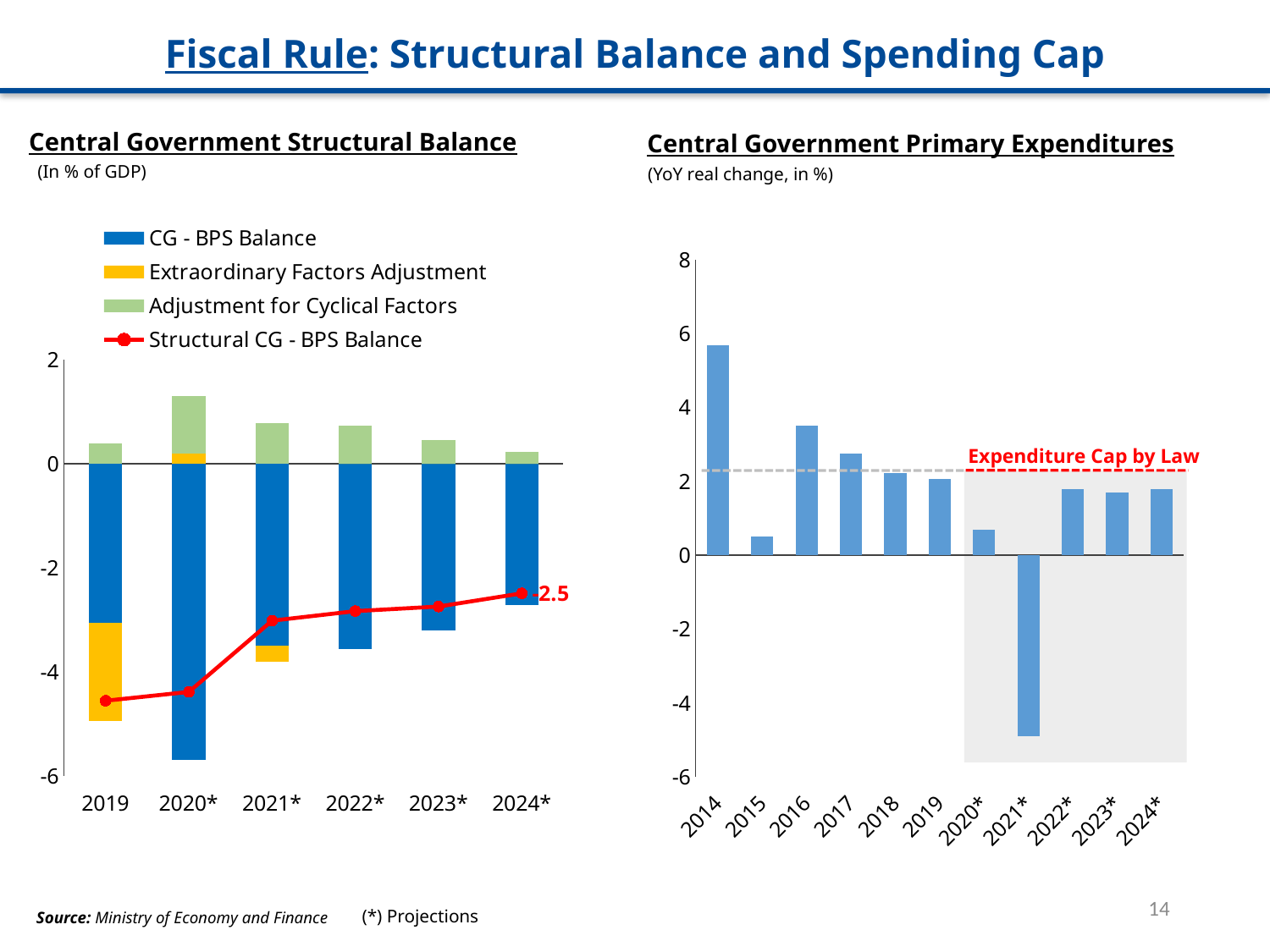
In the Central Government Primary Expenditures chart, is the value for 2014 greater or less than 4? greater In the Central Government Primary Expenditures chart, which year has the larger value, 2015 or 2016? 2016 How many years are shown on the x axis of the Central Government Structural Balance chart? 6 In the Central Government Primary Expenditures chart, which year has the lowest value? 2021* In the Central Government Primary Expenditures chart, is the value for 2021* greater or less than -2? less What is the label on the dashed horizontal line in the Central Government Primary Expenditures chart? Expenditure Cap by Law In the Central Government Structural Balance chart, what is the labelled value of the Structural CG - BPS Balance in 2024*? -2.5 How many series does the legend of the Central Government Structural Balance chart list? 4 What kind of chart is the Central Government Primary Expenditures chart? bar chart In the Central Government Structural Balance chart, does the Structural CG - BPS Balance line rise or fall from 2019 to 2024*? rise How many years are shown on the x axis of the Central Government Primary Expenditures chart? 11 In the Central Government Primary Expenditures chart, which year has the highest value? 2014